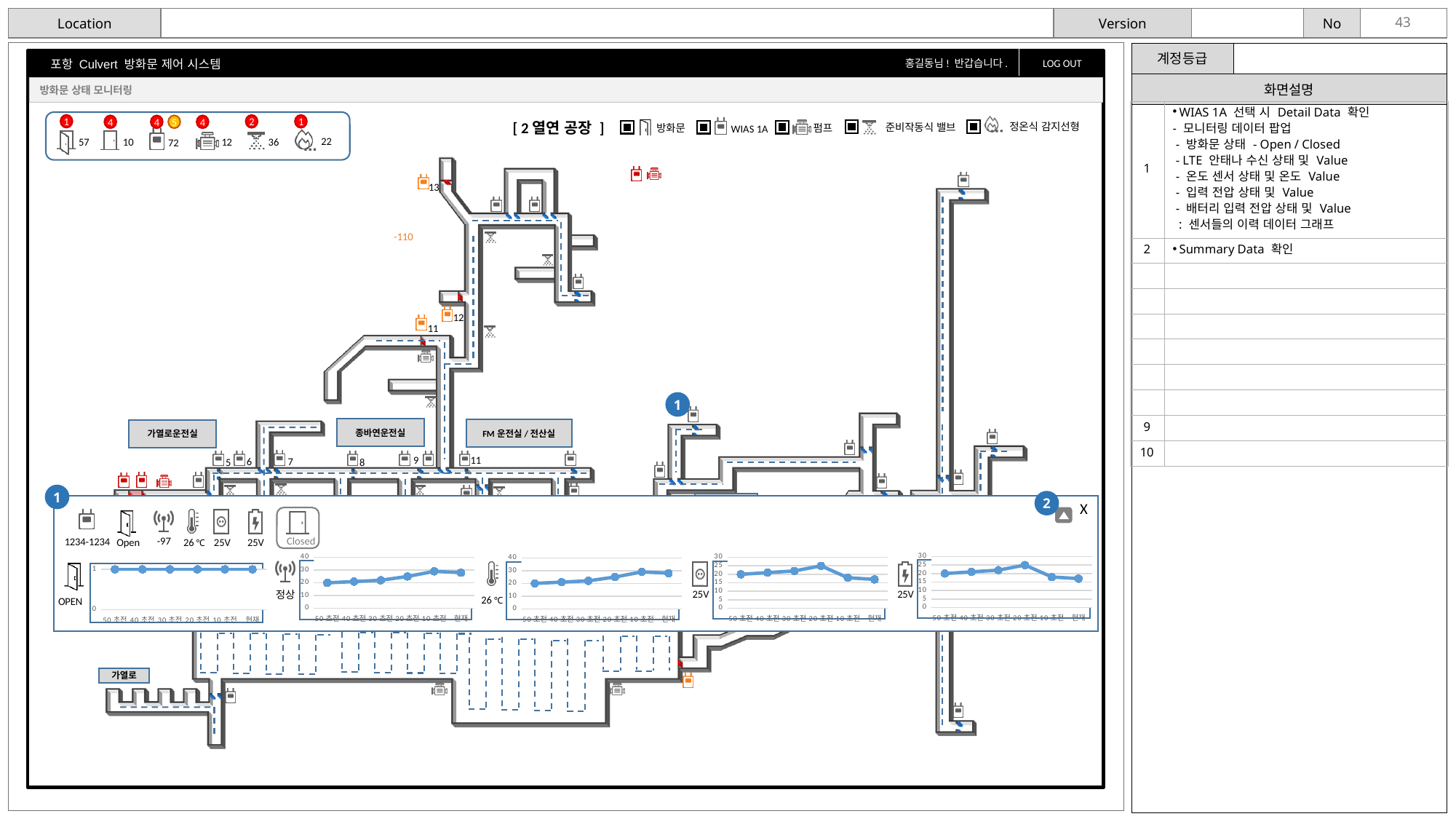
On the temperature chart (third from the left, next to 26 ℃), do the values rise or fall from 50 초전 to 현재? rise On the fourth chart from the left (next to 25V), which x-axis category has the highest value? 20 초전 On the fourth chart from the left (next to 25V), is the value at 20 초전 greater or less than 20? greater What is the label of the first x-axis category on the charts in the popup panel? 50 초전 On the leftmost chart (next to OPEN), what is the highest y-axis tick value shown? 1 How many data points are plotted on the temperature chart (third from the left, next to 26 ℃)? 6 On the second chart from the left (next to 정상), do the values rise or fall from 50 초전 to 현재? rise On the fourth chart from the left (next to 25V), is the value at 현재 greater or less than 20? less What is the label of the last x-axis category on the charts in the popup panel? 현재 How many small line charts are shown in the popup panel at the bottom of the slide? 5 On the temperature chart (third from the left), is the value at 현재 greater or less than 20? greater What kind of chart is the second chart from the left in the popup panel (next to the 정상 label)? line chart